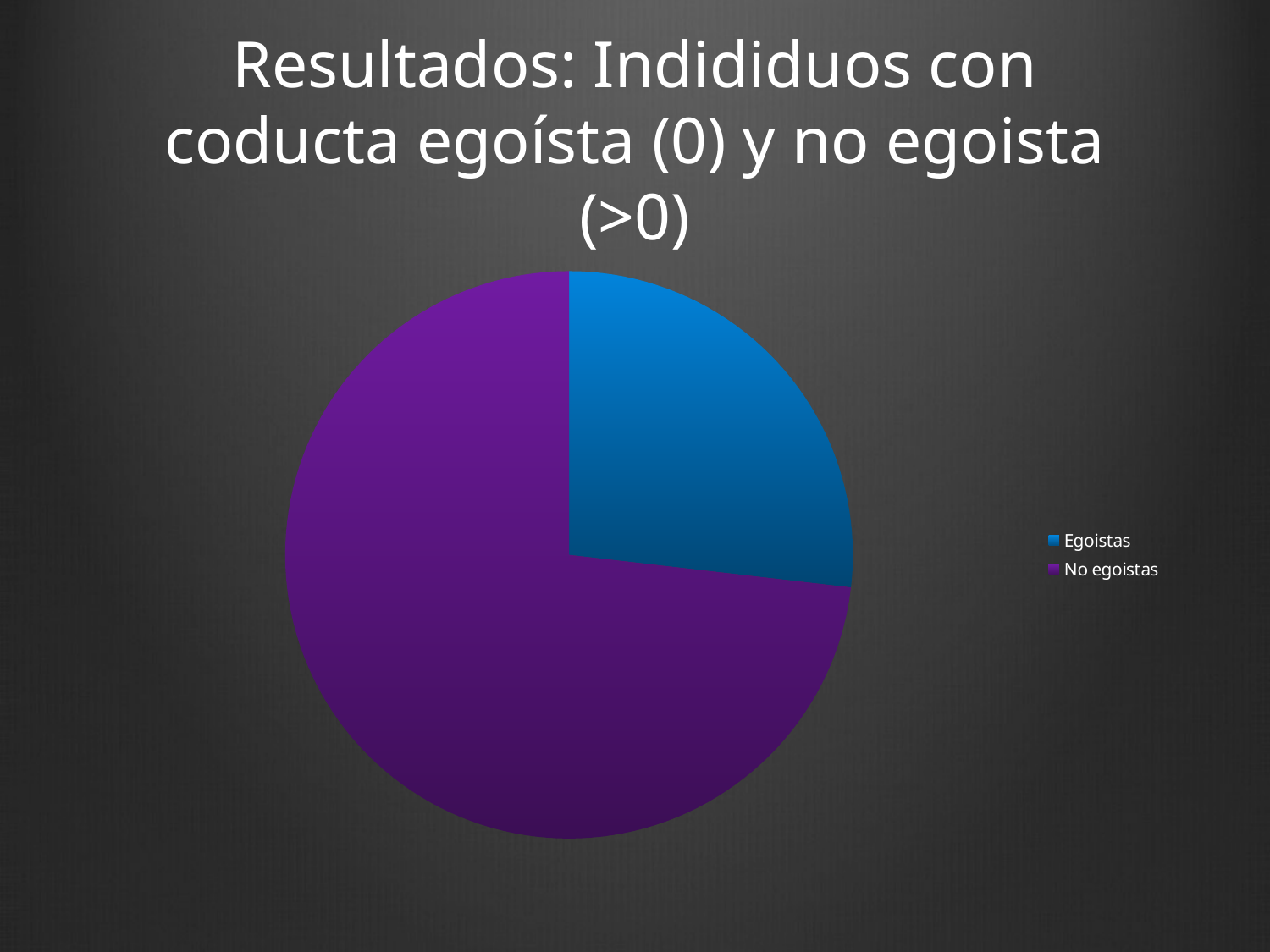
How many slices does the pie chart have? 2 Which category has the smallest slice of the pie? Egoistas Is the Egoistas slice larger or smaller than half of the pie? smaller What kind of chart is shown on the slide? pie chart What colour is the Egoistas slice? blue How many entries does the legend list? 2 Which category has the largest slice of the pie? No egoistas What is the title of the slide? Resultados: Indididuos con coducta egoísta (0) y no egoista (>0) Which slice is larger, Egoistas or No egoistas? No egoistas